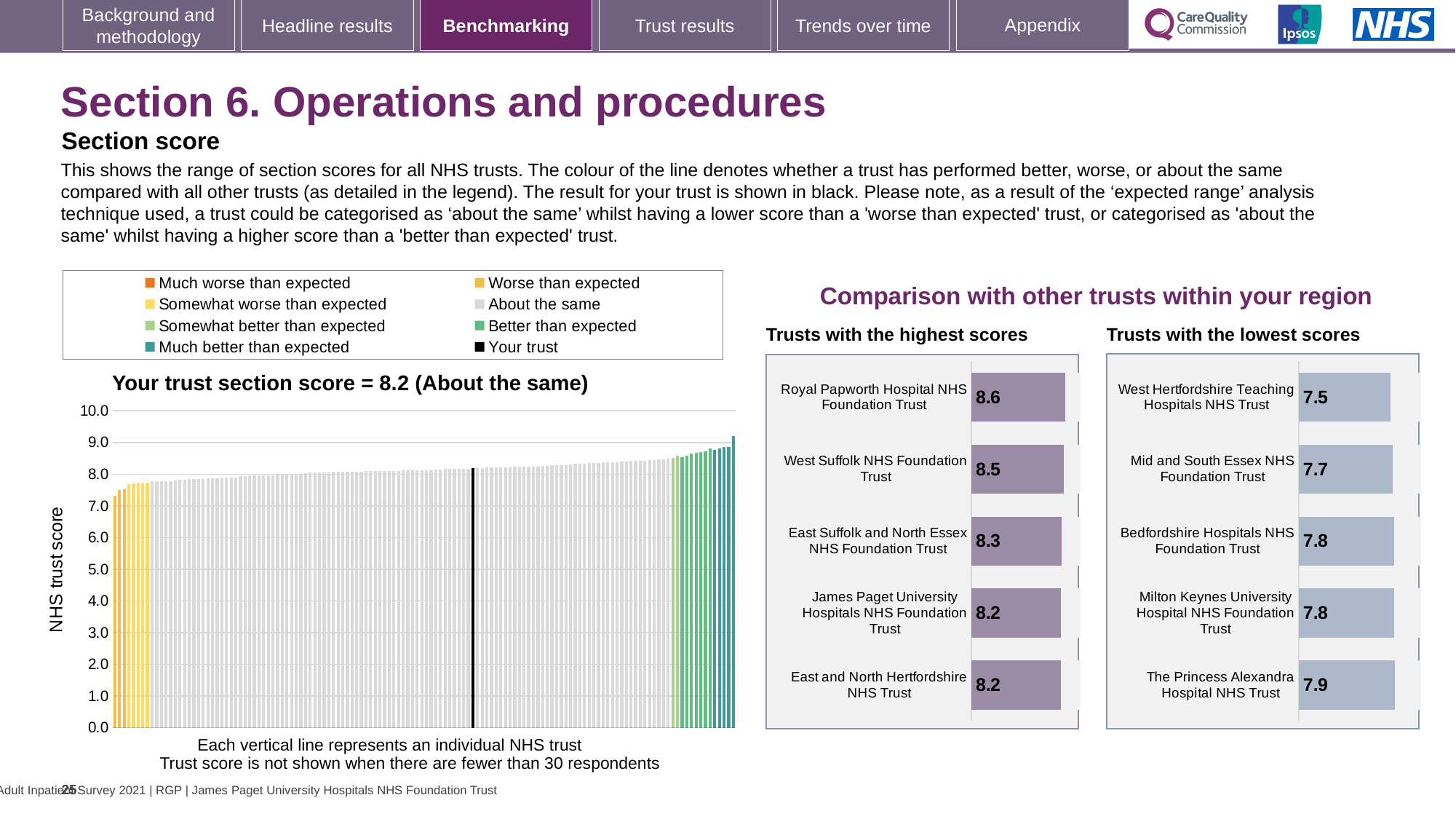
In the 'Trusts with the highest scores' chart, what is the difference between the scores of Royal Papworth Hospital NHS Foundation Trust and East Suffolk and North Essex NHS Foundation Trust? 0.3 In the 'Trusts with the lowest scores' chart, which trust has the lowest score? West Hertfordshire Teaching Hospitals NHS Trust In the 'Trusts with the highest scores' chart, what is the score for Royal Papworth Hospital NHS Foundation Trust? 8.6 According to the title of the main chart on the left, what is your trust's section score? 8.2 (About the same) How many trusts are listed in the 'Trusts with the highest scores' chart? 5 In the 'Your trust section score' chart on the left, do the trust scores rise or fall from left to right along the x axis? Rise In the 'Trusts with the lowest scores' chart, what is the score for West Hertfordshire Teaching Hospitals NHS Trust? 7.5 How many entries does the legend above the 'Your trust section score' chart list? 8 In the 'Trusts with the highest scores' chart, which trust has the highest score? Royal Papworth Hospital NHS Foundation Trust In the 'Trusts with the lowest scores' chart, which has the larger score: Mid and South Essex NHS Foundation Trust or The Princess Alexandra Hospital NHS Trust? The Princess Alexandra Hospital NHS Trust What kind of chart is the 'Your trust section score' chart on the left? Bar chart In the 'Trusts with the lowest scores' chart, what is the score for Bedfordshire Hospitals NHS Foundation Trust? 7.8